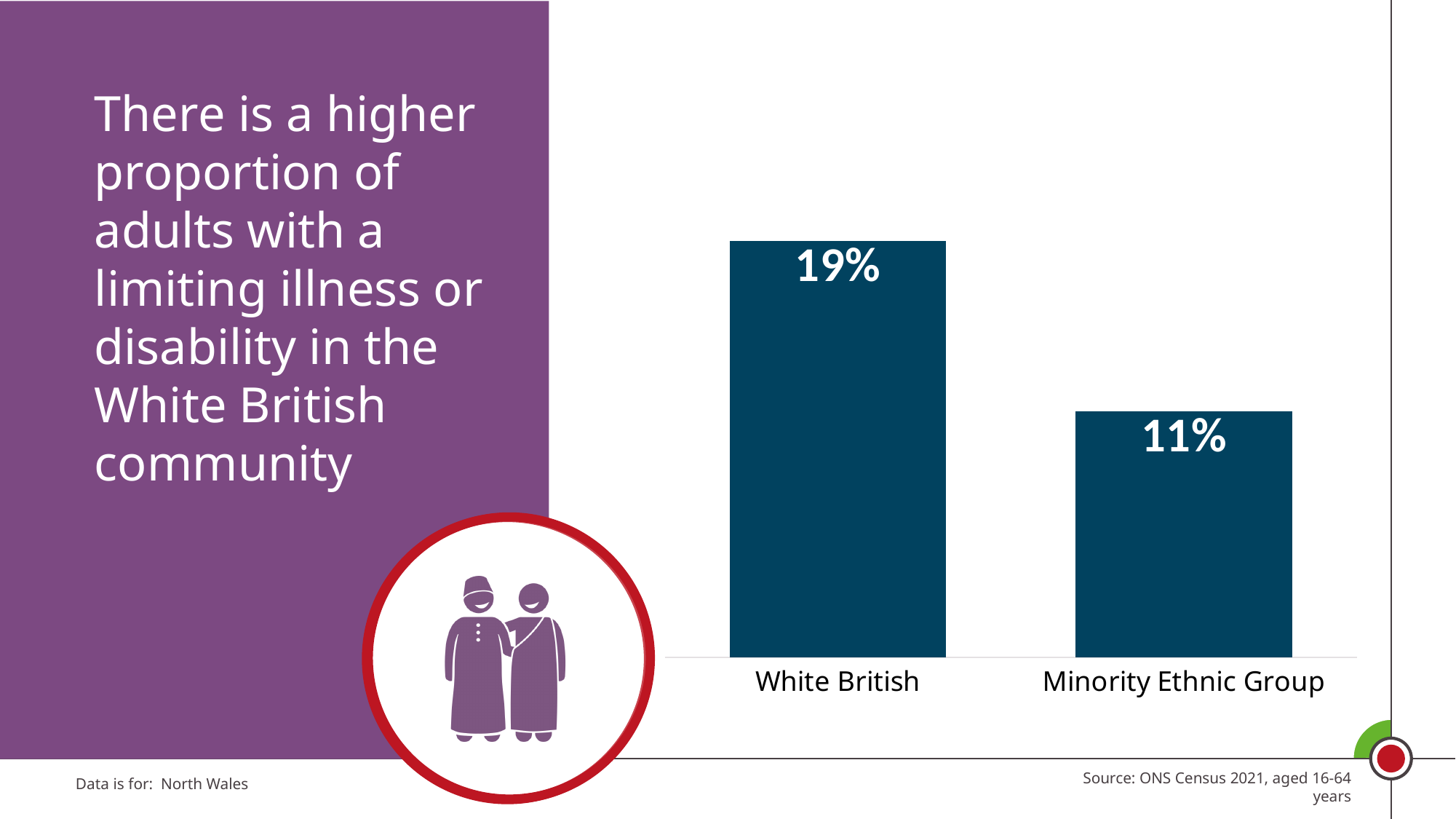
What kind of chart is shown on the slide? Bar chart Which area is the chart data for? North Wales Do the values rise or fall from left to right across the categories? Fall Which category has the lowest value? Minority Ethnic Group Which category has the highest value? White British What is the difference between the values for White British and Minority Ethnic Group? 8% What is the source of the data shown in the chart? ONS Census 2021, aged 16-64 years What is the value for White British? 19% What is the value for Minority Ethnic Group? 11% How many categories are shown in the chart? 2 Which is larger, the value for White British or the value for Minority Ethnic Group? White British